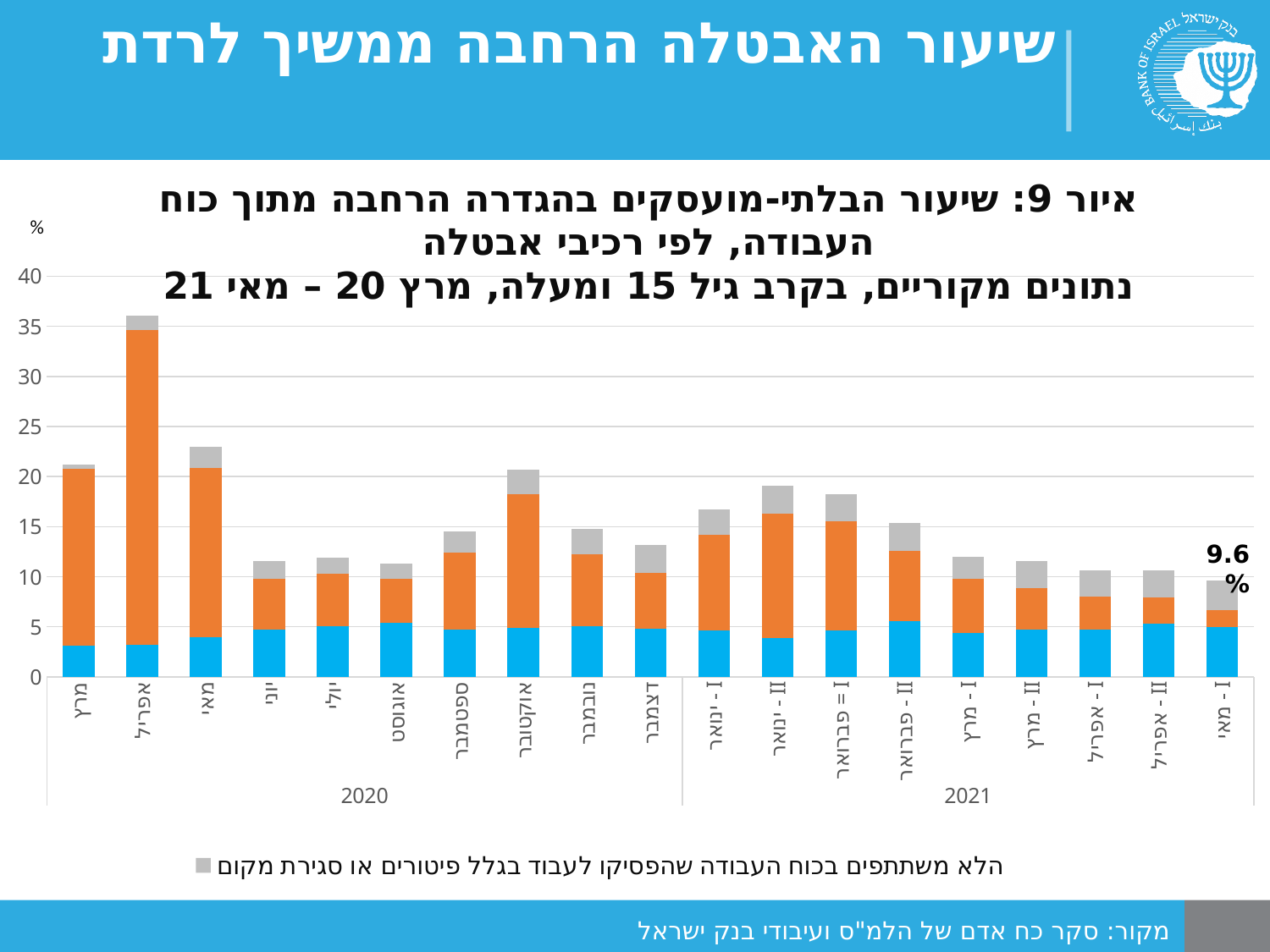
Which two years are labelled along the x axis of the chart? 2020 and 2021 What value is labelled on the bar for מאי - I 2021? 9.6% Which bar is taller: אפריל 2020 or מאי 2020? אפריל 2020 Is the total value for אפריל 2020 greater or less than 30? greater Which bar is taller: דצמבר 2020 or ינואר - II 2021? ינואר - II 2021 Is the total value for אוגוסט 2020 greater or less than 15? less How many bars are plotted in the chart? 19 Is the total value for אוקטובר 2020 greater or less than 15? greater Which month has the lowest bar in the chart? מאי - I 2021 Do the bar totals rise or fall from ינואר - II 2021 to מאי - I 2021? Fall What kind of chart is shown on the slide? Stacked bar chart Which month has the highest bar in the chart? אפריל 2020